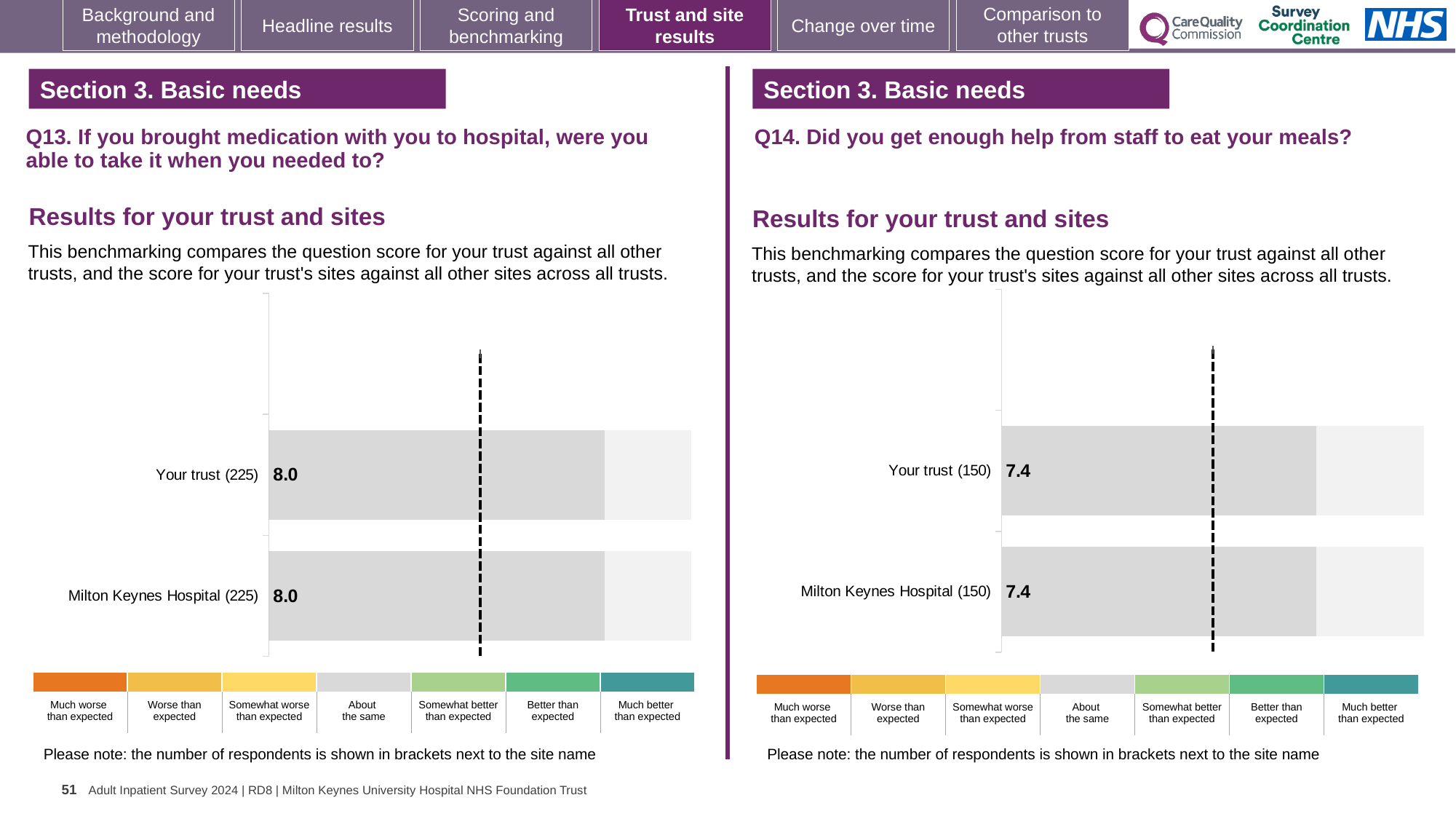
How many bars are plotted on the Q14 chart (right)? 2 On the Q13 chart (left), how many respondents are shown in brackets next to Your trust? 225 On the Q14 chart (right), what is the difference between the score for Your trust and the score for Milton Keynes Hospital? 0.0 On the Q13 chart (left), what is the score for Your trust? 8.0 On the Q14 chart (right), what is the score for Milton Keynes Hospital? 7.4 What kind of chart is the Q14 chart (right)? Bar chart How many bars are plotted on the Q13 chart (left)? 2 Is the score for Your trust on the Q13 chart (left) larger than, smaller than, or equal to the score for Your trust on the Q14 chart (right)? Larger On the Q13 chart (left), what is the score for Milton Keynes Hospital? 8.0 On the Q13 chart (left), what is the difference between the score for Your trust and the score for Milton Keynes Hospital? 0.0 On the Q14 chart (right), what is the score for Your trust? 7.4 On the Q14 chart (right), how many respondents are shown in brackets next to Milton Keynes Hospital? 150